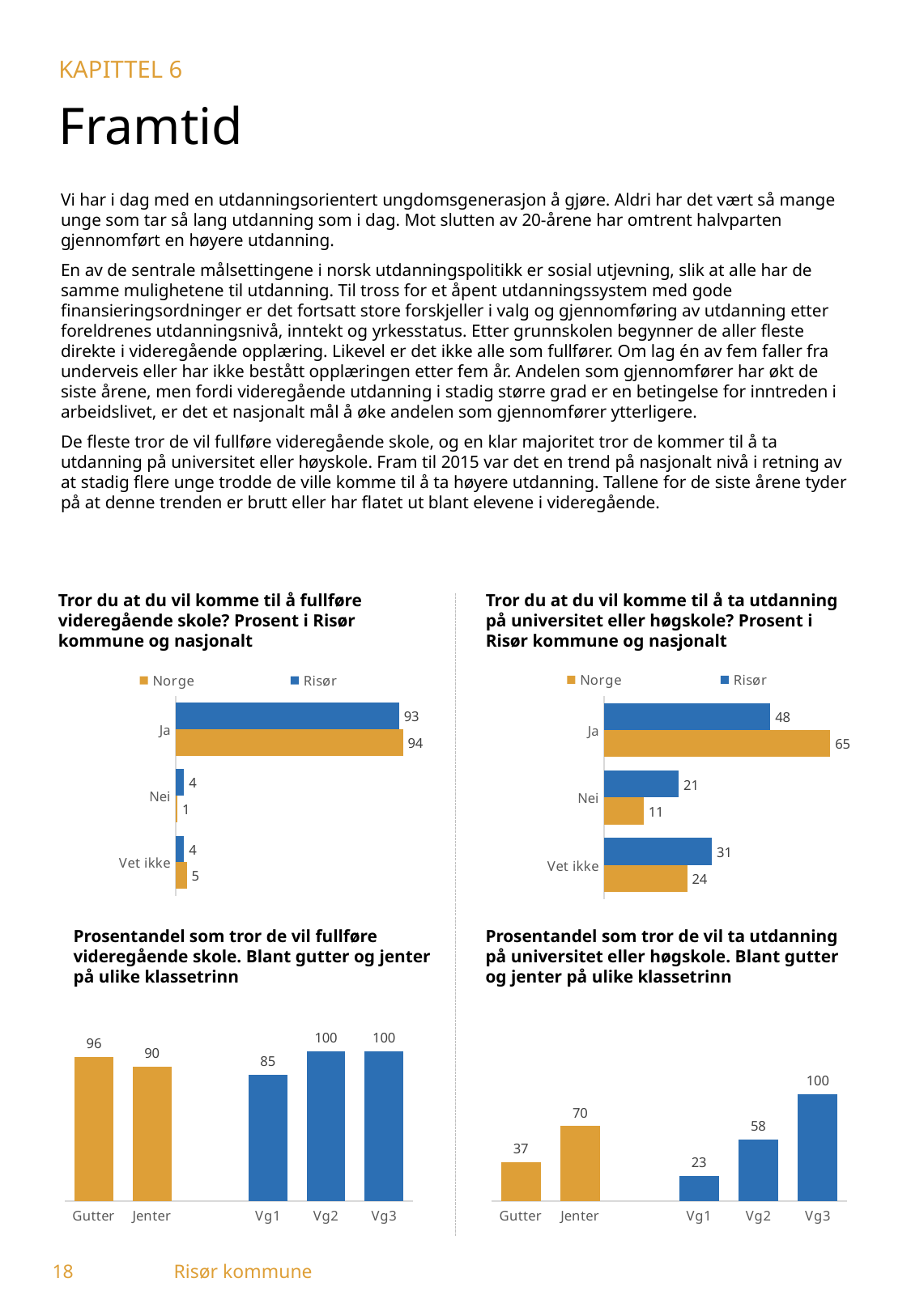
In the top-right chart (Tror du at du vil komme til å ta utdanning på universitet eller høgskole?), what kind of chart is it? Bar chart In the top-left chart (Tror du at du vil komme til å fullføre videregående skole?), what is the value for Risør for 'Ja'? 93 In the top-left chart (Tror du at du vil komme til å fullføre videregående skole?), how many series does the legend list? 2 In the top-left chart (Tror du at du vil komme til å fullføre videregående skole?), what is the value for Norge for 'Nei'? 1 In the top-right chart (Tror du at du vil komme til å ta utdanning på universitet eller høgskole?), what is the difference between Norge and Risør for 'Ja'? 17 In the bottom-left chart (Prosentandel som tror de vil fullføre videregående skole), which category has the lowest value? Vg1 In the top-right chart (Tror du at du vil komme til å ta utdanning på universitet eller høgskole?), which is larger for 'Vet ikke', Risør or Norge? Risør In the bottom-left chart (Prosentandel som tror de vil fullføre videregående skole), what is the value for Vg1? 85 In the bottom-left chart (Prosentandel som tror de vil fullføre videregående skole), how many categories are shown? 5 In the bottom-right chart (Prosentandel som tror de vil ta utdanning på universitet eller høgskole), what is the difference between Jenter and Gutter? 33 In the bottom-right chart (Prosentandel som tror de vil ta utdanning på universitet eller høgskole), which category has the highest value? Vg3 In the top-right chart (Tror du at du vil komme til å ta utdanning på universitet eller høgskole?), what is the value for Norge for 'Ja'? 65